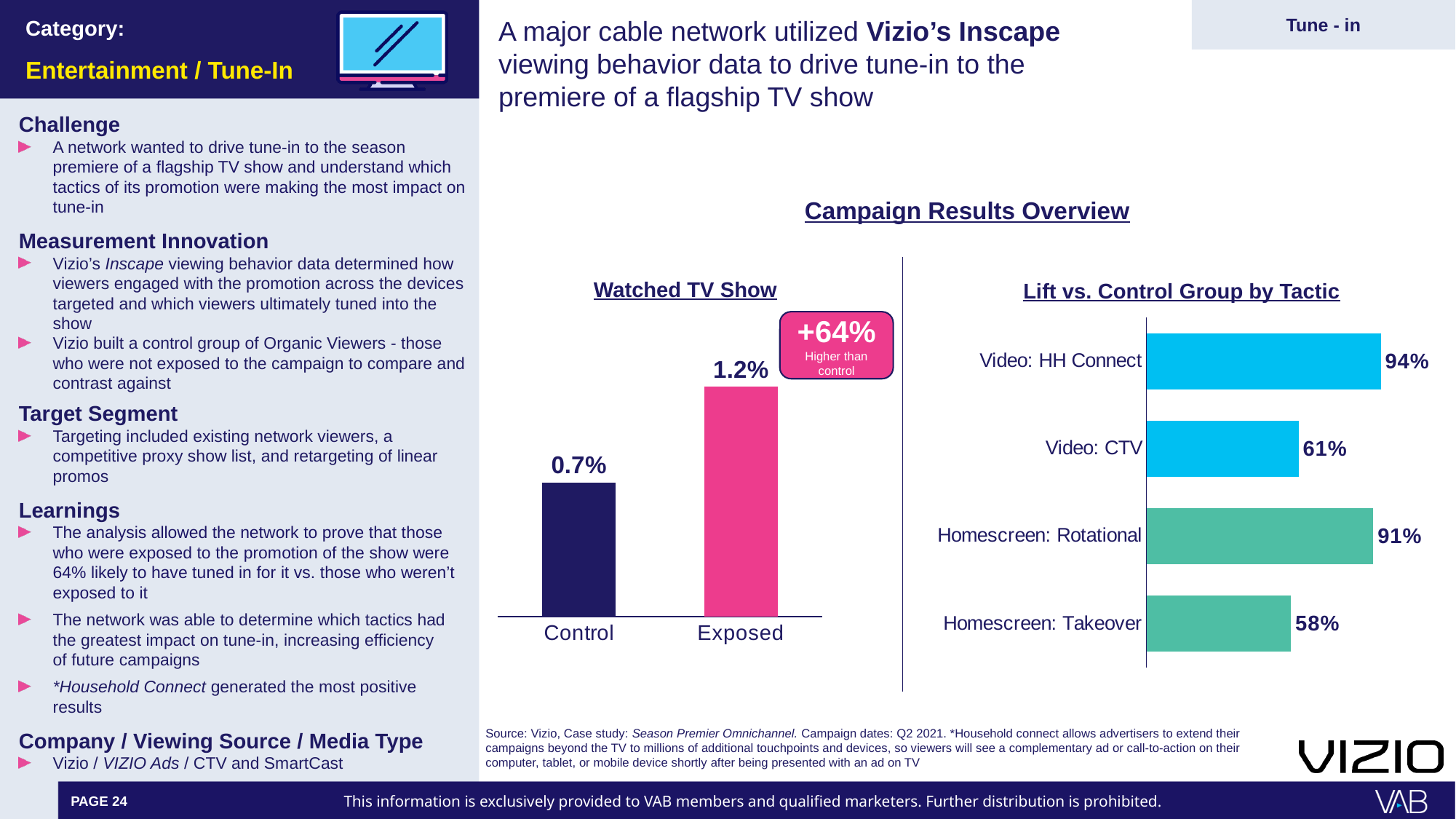
In the 'Lift vs. Control Group by Tactic' chart, what is the value for Video: HH Connect? 94% In the 'Lift vs. Control Group by Tactic' chart, what is the value for Homescreen: Takeover? 58% In the 'Watched TV Show' chart, what is the value for Exposed? 1.2% In the 'Watched TV Show' chart, what percentage higher than control is the Exposed group, according to the callout? +64% In the 'Watched TV Show' chart, what is the value for Control? 0.7% In the 'Watched TV Show' chart, which bar is higher, Control or Exposed? Exposed What type of chart is the 'Lift vs. Control Group by Tactic' chart? Bar chart In the 'Lift vs. Control Group by Tactic' chart, which tactic has the highest lift? Video: HH Connect In the 'Lift vs. Control Group by Tactic' chart, which tactic has the lowest lift? Homescreen: Takeover In the 'Watched TV Show' chart, what is the difference between the Exposed and Control values? 0.5% In the 'Lift vs. Control Group by Tactic' chart, what is the difference between Video: CTV and Homescreen: Rotational? 30% In the 'Watched TV Show' chart, how many bars are plotted? 2